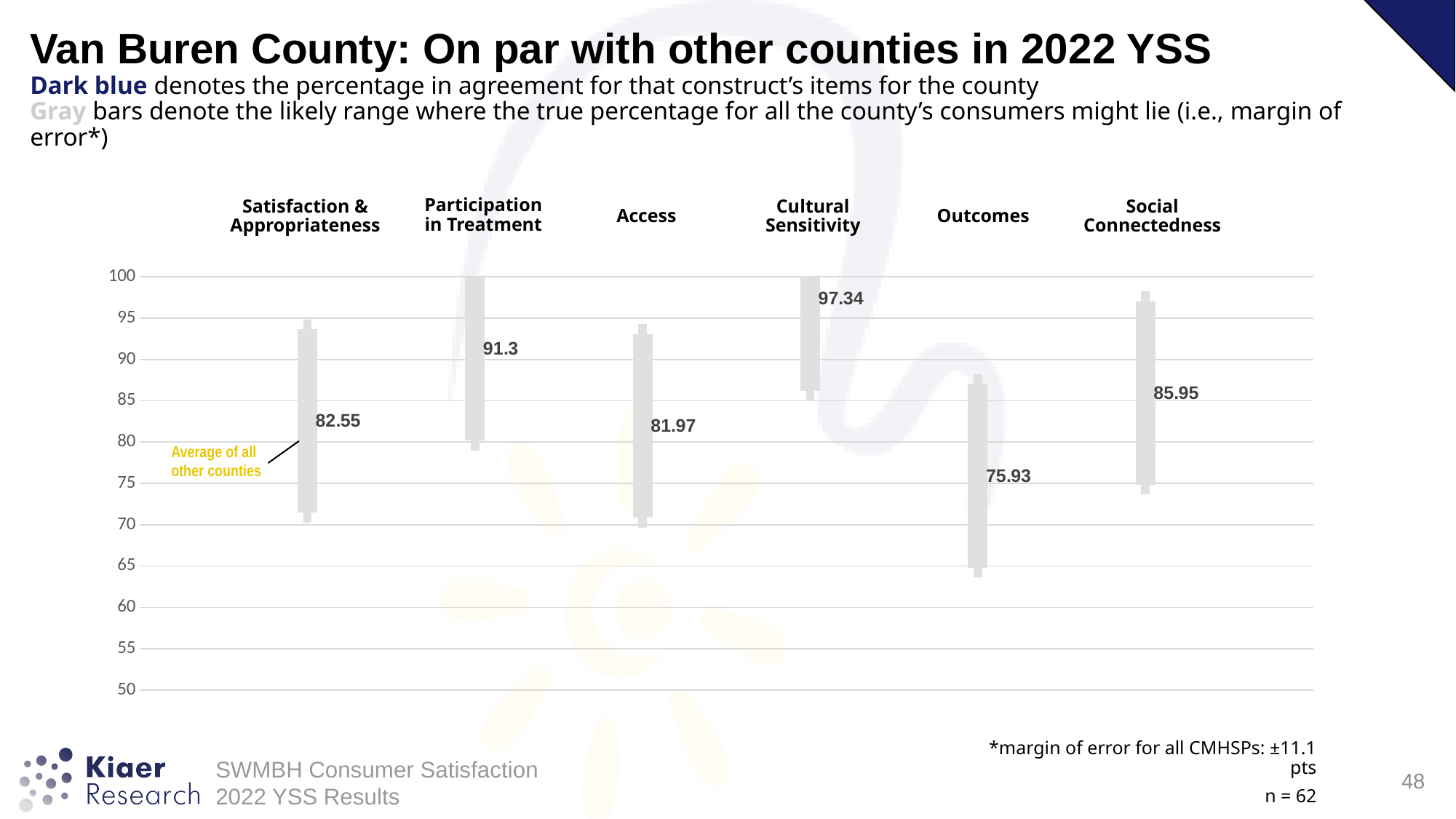
Which construct has the lowest labeled value? Outcomes What is the value labeled for Participation in Treatment? 91.3 Which construct has the highest labeled value? Cultural Sensitivity What is the value labeled for Cultural Sensitivity? 97.34 What is the value labeled for Social Connectedness? 85.95 Is the labeled value for Outcomes greater or less than 80? less Which has a larger labeled value, Participation in Treatment or Access? Participation in Treatment What kind of chart is shown on the slide? bar chart What is the value labeled for Outcomes? 75.93 What is the difference between the labeled values for Cultural Sensitivity and Outcomes? 21.41 According to the slide, what do the gray bars denote? The likely range where the true percentage for all the county's consumers might lie (margin of error) How many constructs are shown on the chart? 6